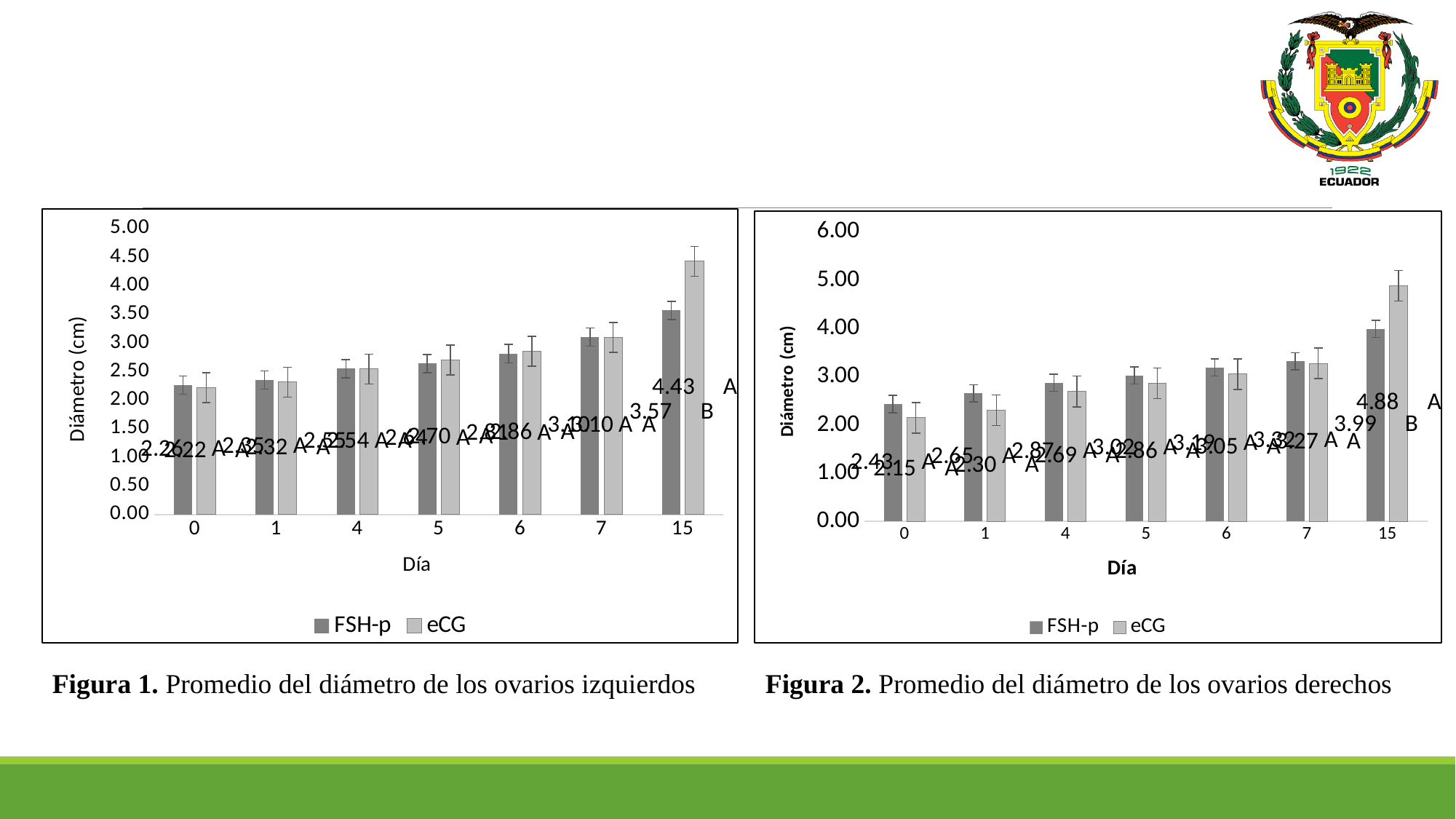
In Figura 1 (left chart), what is the FSH-p value on day 15? 3.57 In Figura 1 (left chart), how many series does the legend list? 2 In Figura 2 (right chart), what is the eCG value on day 15? 4.88 In Figura 2 (right chart), do the FSH-p values rise or fall from day 0 to day 15? Rise In Figura 2 (right chart), what is the y-axis title? Diámetro (cm) In Figura 1 (left chart), is the eCG value on day 15 greater or less than 4.00? greater In Figura 1 (left chart), what is the eCG value on day 15? 4.43 In Figura 1 (left chart), on which day is the eCG value highest? 15 In Figura 1 (left chart), what is the difference between the eCG and FSH-p values on day 15? 0.86 In Figura 2 (right chart), what is the FSH-p value on day 15? 3.99 In Figura 1 (left chart), what kind of chart is shown? Bar chart In Figura 1 (left chart), how many day categories are shown on the x axis? 7